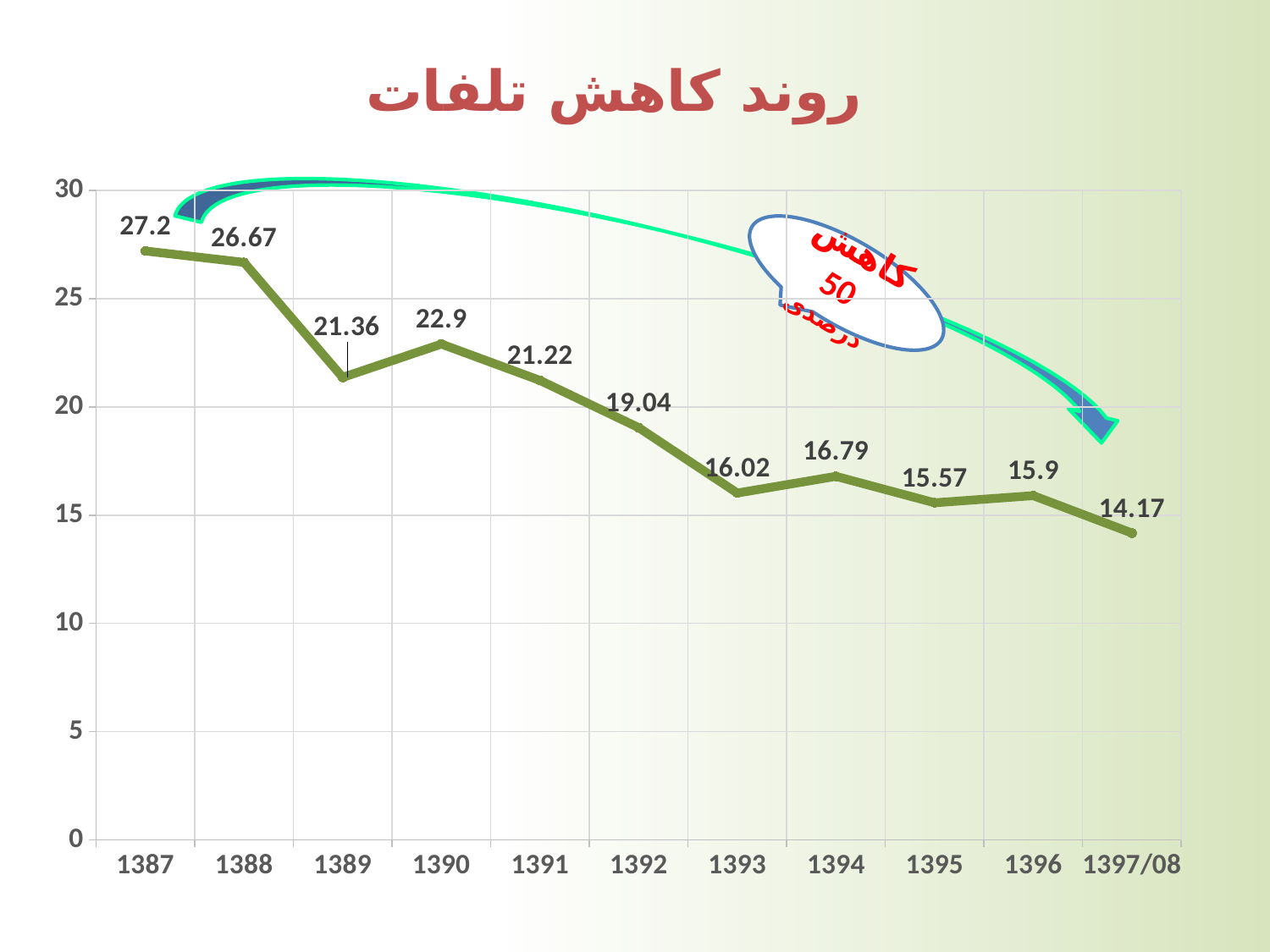
Which year has the lowest value? 1397/08 What is the difference between the values for 1387 and 1397/08? 13.03 Do the values generally rise or fall from 1387 to 1397/08? Fall What is the value for 1390? 22.9 What is the value for 1393? 16.02 How many data points are plotted on the line? 11 What is the value for 1397/08? 14.17 What is the title of the chart? روند کاهش تلفات What is the value for 1387? 27.2 Which is larger, the value for 1389 or the value for 1390? 1390 Which year has the highest value? 1387 What kind of chart is shown on the slide? Line chart